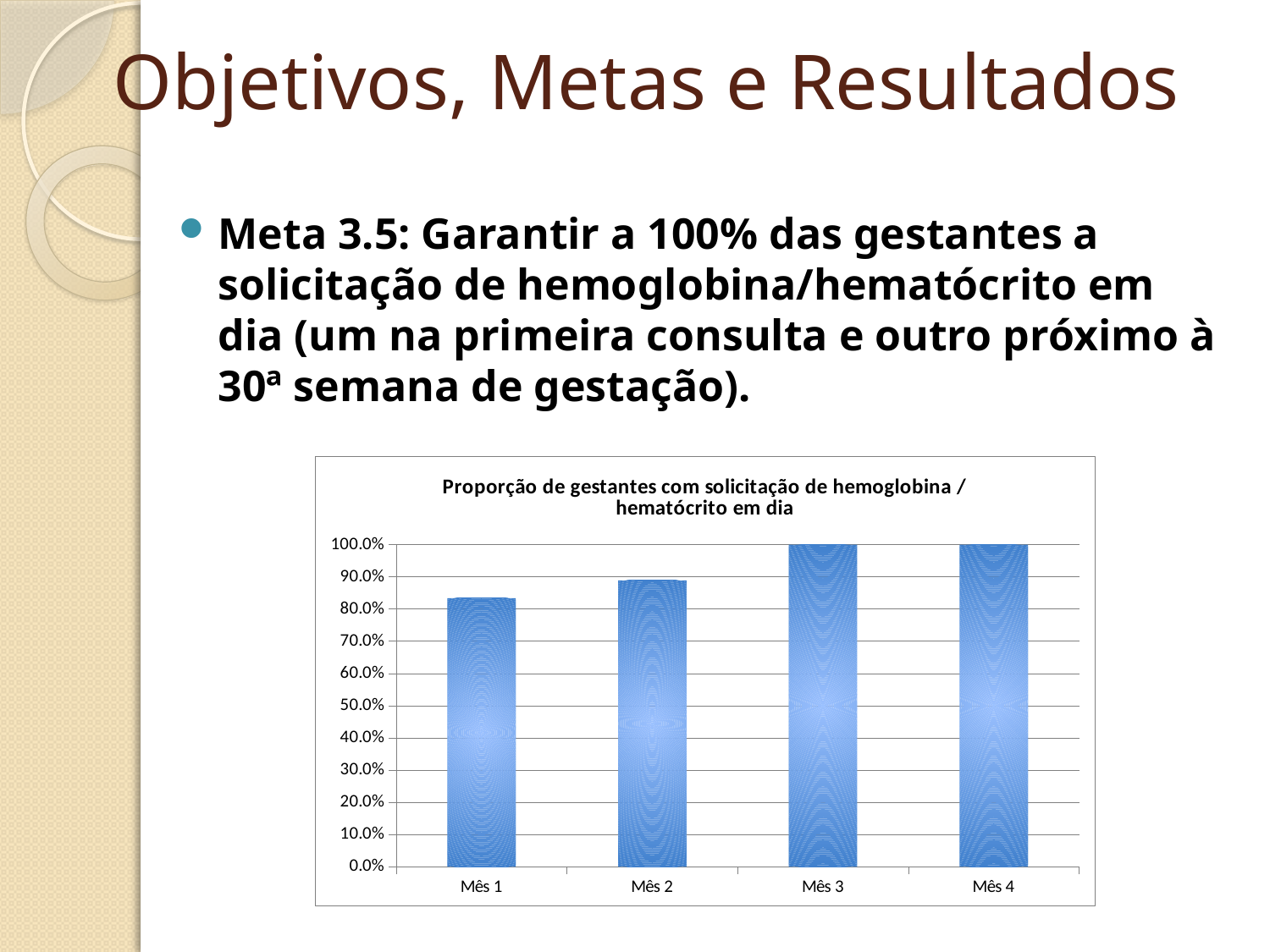
Is the value for Mês 1 greater or less than 90.0%? less Is the value for Mês 1 greater or less than 80.0%? greater What kind of chart is shown on the slide? bar chart What is the title of the chart? Proporção de gestantes com solicitação de hemoglobina / hematócrito em dia How many months reach 100.0% in the chart? 2 What is the value for Mês 3? 100.0% What is the value for Mês 4? 100.0% Which is larger, the value for Mês 1 or the value for Mês 2? Mês 2 Do the values rise or fall from Mês 1 to Mês 4? rise How many months (categories) are plotted in the chart? 4 Is the value for Mês 2 greater or less than 80.0%? greater Which month has the lowest value in the chart? Mês 1